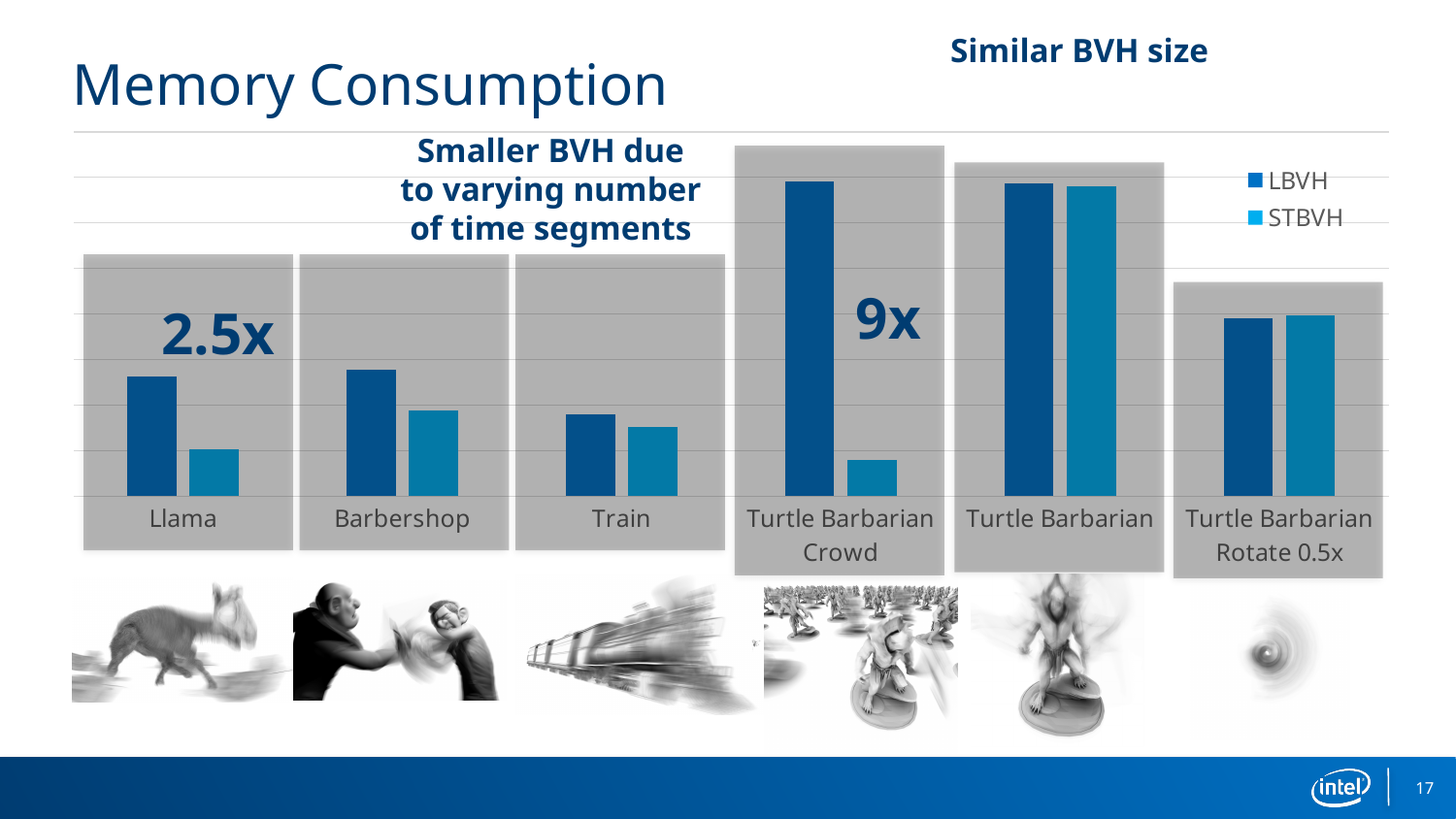
For Llama, which is larger, the LBVH bar or the STBVH bar? LBVH What kind of chart is shown on the slide? bar chart Which category has the lowest LBVH bar? Train What is the title of the slide containing the chart? Memory Consumption What ratio label is printed next to the Turtle Barbarian Crowd bars? 9x For Turtle Barbarian Crowd, which is larger, the LBVH bar or the STBVH bar? LBVH For Barbershop, which is larger, the LBVH bar or the STBVH bar? LBVH How many series does the chart's legend list? 2 Which category has the lowest STBVH bar? Turtle Barbarian Crowd How many categories are shown along the x axis of the chart? 6 Which category has the highest STBVH bar? Turtle Barbarian